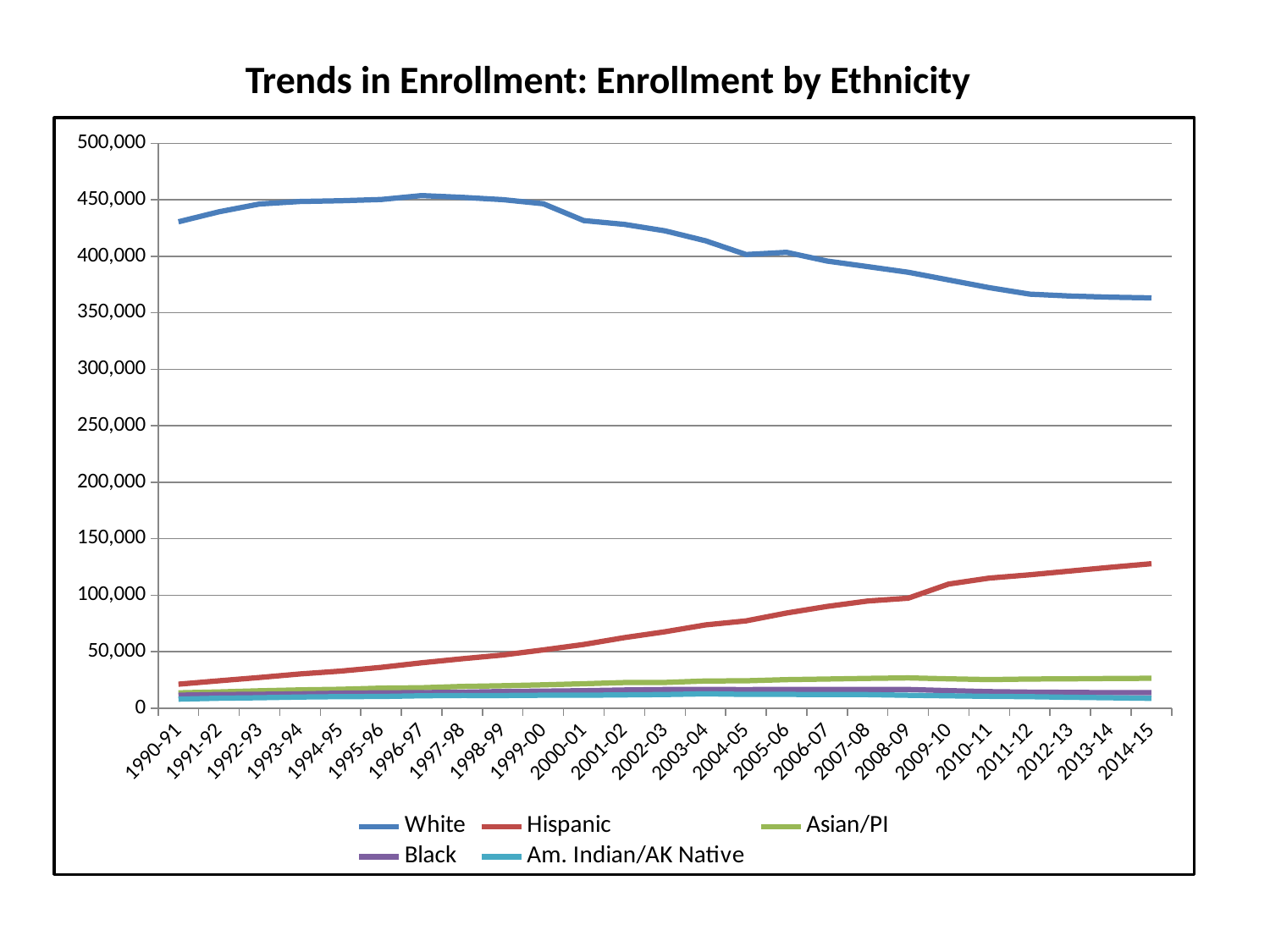
Does the Hispanic enrollment line rise or fall overall from 1990-91 to 2014-15? Rise Is the White enrollment value for 1990-91 greater or less than 400,000? greater Is the Hispanic enrollment value for 2014-15 greater or less than 100,000? greater Which ethnicity has the lowest enrollment in 2014-15? Am. Indian/AK Native What kind of chart is shown on the slide? Line chart Which ethnicity has the highest enrollment in 2014-15? White How many series does the legend list? 5 In 2014-15, which is larger, Hispanic enrollment or Asian/PI enrollment? Hispanic How many school years are shown along the x axis? 25 Does the White enrollment line rise or fall overall from 1990-91 to 2014-15? Fall Which series is plotted with the red line? Hispanic What is the title of the chart? Trends in Enrollment: Enrollment by Ethnicity